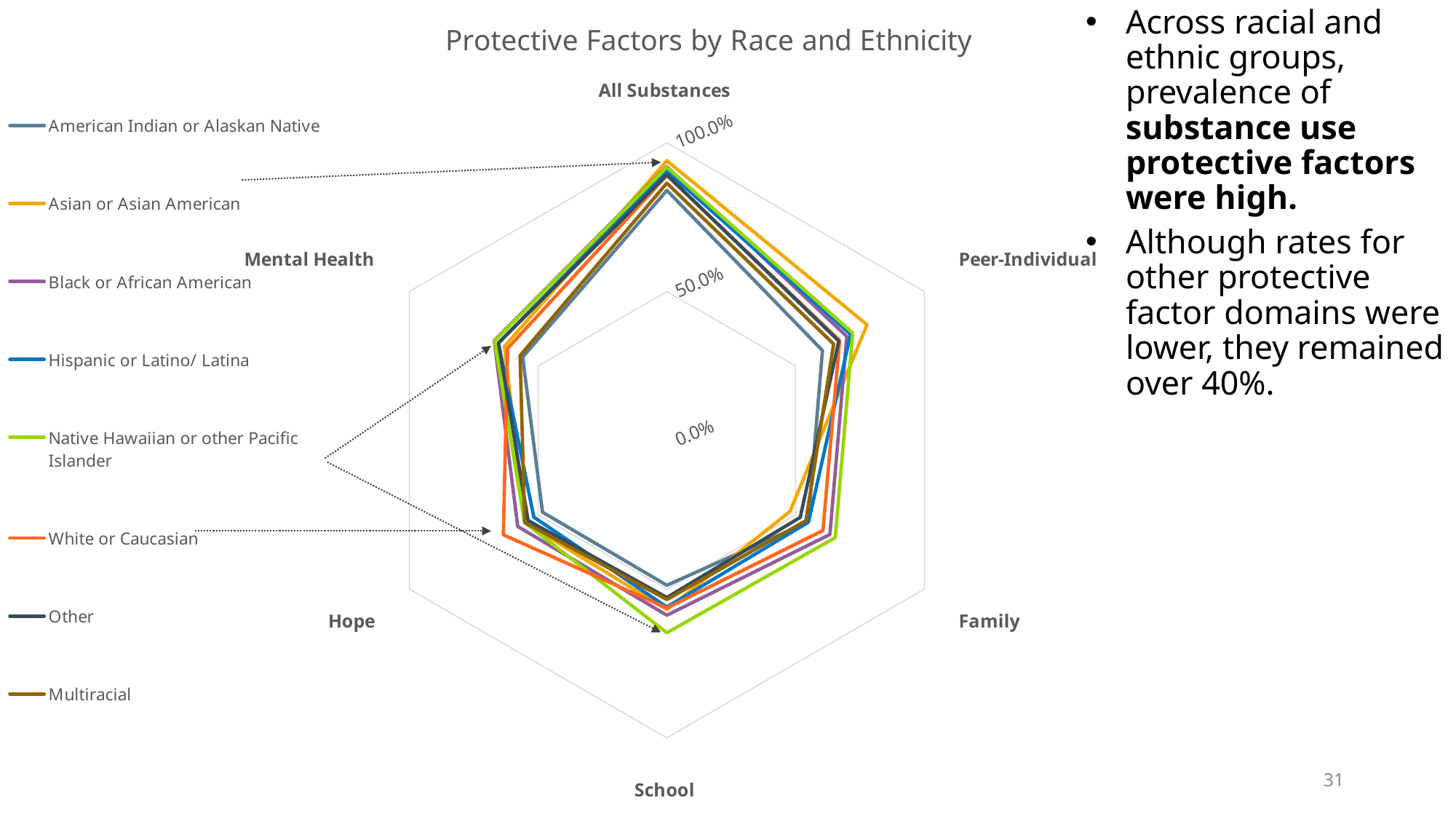
What is the title of the chart? Protective Factors by Race and Ethnicity Which series has the lowest value on the School axis? American Indian or Alaskan Native Is the value for Asian or Asian American on the All Substances axis greater or less than 50.0%? greater Which series has the highest value on the Family axis? Native Hawaiian or other Pacific Islander Which series has the highest value on the Hope axis? White or Caucasian How many protective factor domains (axes) are plotted on the chart? 6 What is the highest percentage tick shown on the chart's axis? 100.0% Is the value for White or Caucasian on the Mental Health axis greater or less than 50.0%? greater Is the value for Native Hawaiian or other Pacific Islander on the School axis greater or less than 50.0%? greater What kind of chart is shown on the slide? Radar chart Which series has the highest value on the Peer-Individual axis? Asian or Asian American How many series does the legend list? 8